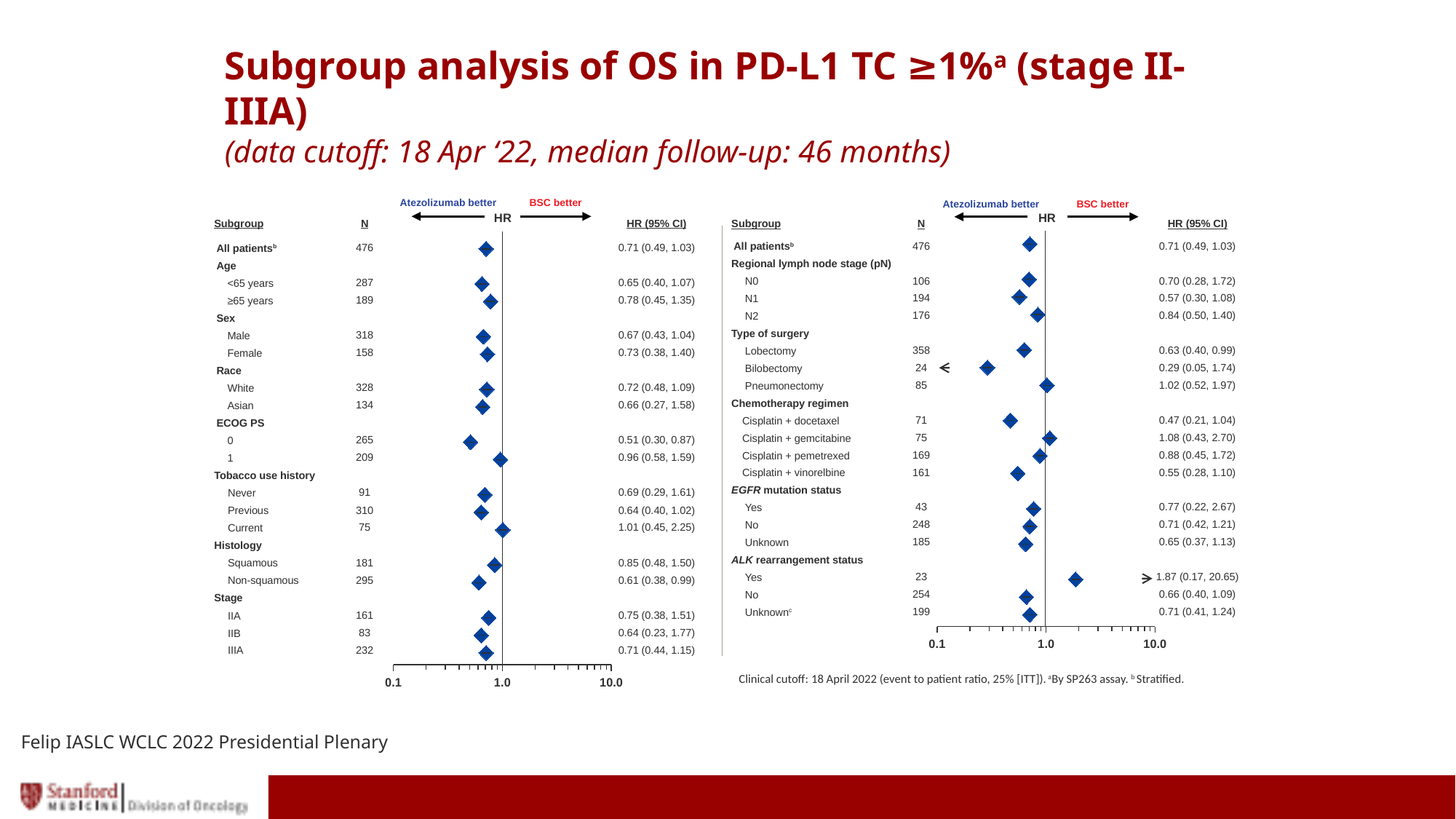
In the left forest plot, which has the larger hazard ratio, Squamous or Non-squamous histology? Squamous In the right forest plot, what is the HR (95% CI) for the Bilobectomy subgroup? 0.29 (0.05, 1.74) In the left forest plot, what is the HR (95% CI) for the ECOG PS 0 subgroup? 0.51 (0.30, 0.87) In the left forest plot, what is N for the Previous tobacco use subgroup? 310 According to the arrow labels above the forest plots, what does a hazard ratio to the left of 1.0 indicate? Atezolizumab better What kind of chart is shown on the slide? Forest plot In the right forest plot, what is the difference in N between the N1 and N2 subgroups? 18 In the right forest plot, what is the HR (95% CI) for All patients? 0.71 (0.49, 1.03) In the right forest plot, which subgroup has the highest hazard ratio? ALK rearrangement status: Yes In the left forest plot, which subgroup has the lowest hazard ratio? ECOG PS 0 In the right forest plot, is the hazard ratio for Cisplatin + docetaxel greater or less than 1.0? less In the left forest plot, how many Stage subgroups are listed? 3